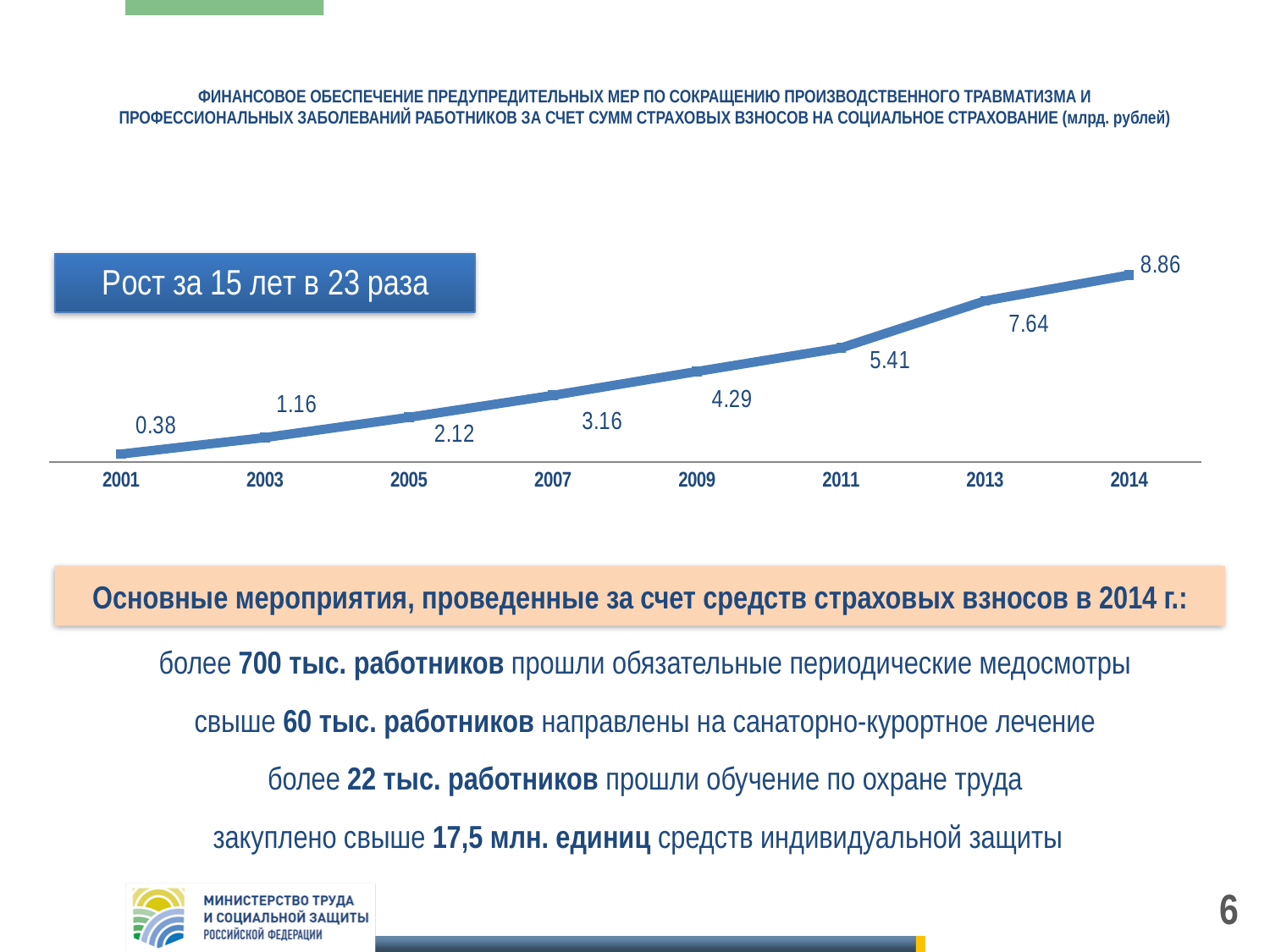
What is the value for 2009? 4.29 What is the difference between the values for 2014 and 2013? 1.22 Which year has the highest value? 2014 Which is larger, the value for 2005 or the value for 2007? 2007 What is the value for 2013? 7.64 Which year has the lowest value? 2001 What is the value for 2014? 8.86 What is the difference between the values for 2011 and 2009? 1.12 Do the values rise or fall from 2001 to 2014? rise What kind of chart is shown? line chart What is the value for 2001? 0.38 How many data points are plotted on the chart? 8